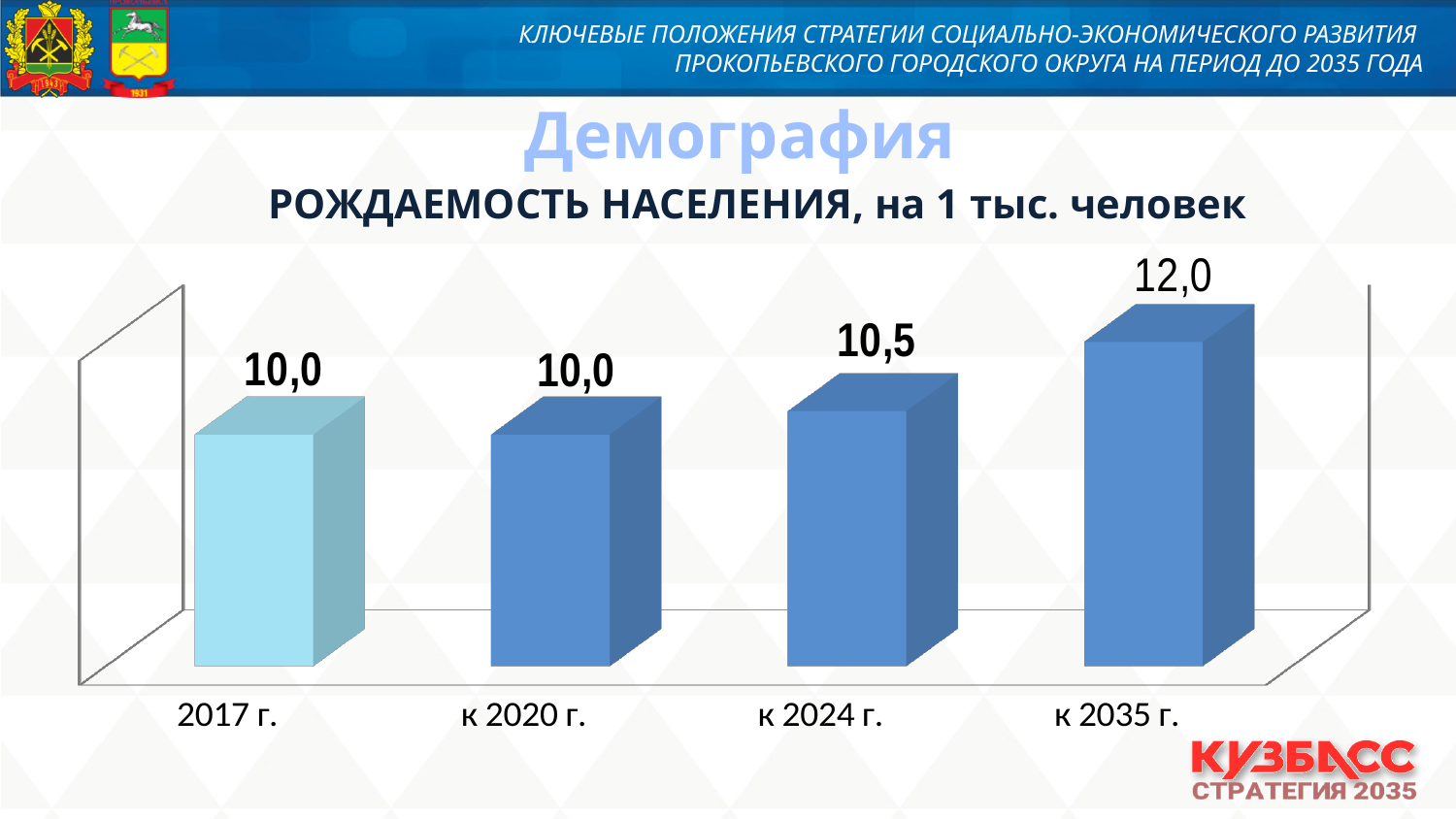
What is the difference between the values for к 2035 г. and 2017 г.? 2,0 Which is larger, the value for к 2024 г. or the value for к 2035 г.? к 2035 г. How many categories are shown on the chart? 4 What is the title of the chart? РОЖДАЕМОСТЬ НАСЕЛЕНИЯ, на 1 тыс. человек What is the difference between the values for к 2024 г. and к 2020 г.? 0,5 Do the values rise or fall from 2017 г. to к 2035 г.? Rise Which category has the highest value? к 2035 г. What is the value shown for к 2024 г.? 10,5 What kind of chart is shown on the slide? Bar chart What is the birth rate value shown for 2017 г.? 10,0 What is the value shown for к 2020 г.? 10,0 What is the value shown for к 2035 г.? 12,0